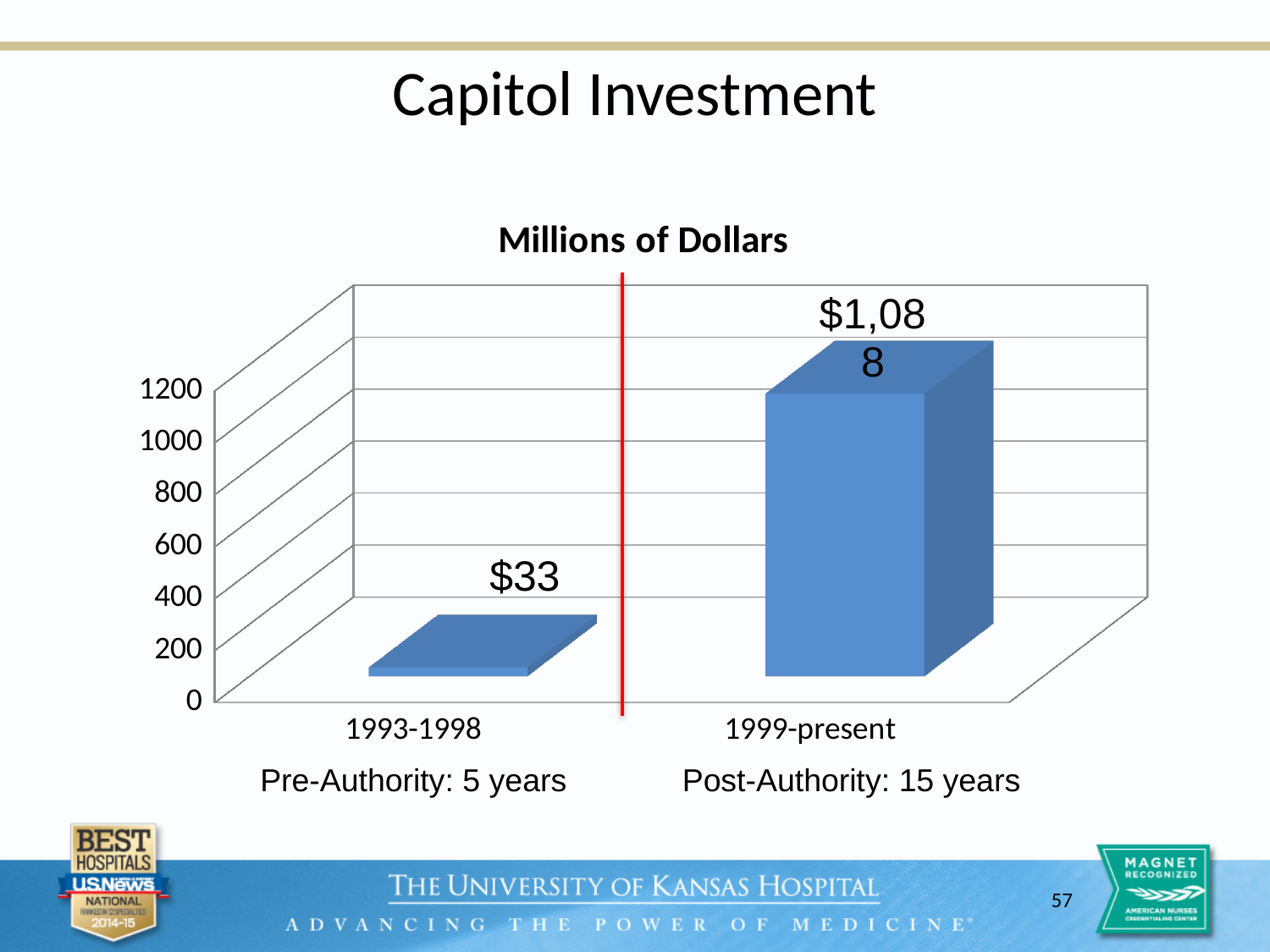
What is the value for 1993-1998 in the Millions of Dollars chart? $33 What is the difference between the values for 1999-present and 1993-1998? $1,055 Which category has the highest value in the chart? 1999-present What is the title shown above the chart? Millions of Dollars Which is larger, the value for 1993-1998 or the value for 1999-present? 1999-present What is the value for 1999-present in the Millions of Dollars chart? $1,088 Is the value for 1993-1998 greater or less than 200? less Is the value for 1999-present greater or less than 1000? greater How many categories are shown on the x axis of the chart? 2 Do the values rise or fall from 1993-1998 to 1999-present? rise Which category has the lowest value in the chart? 1993-1998 What kind of chart is shown on the slide? bar chart